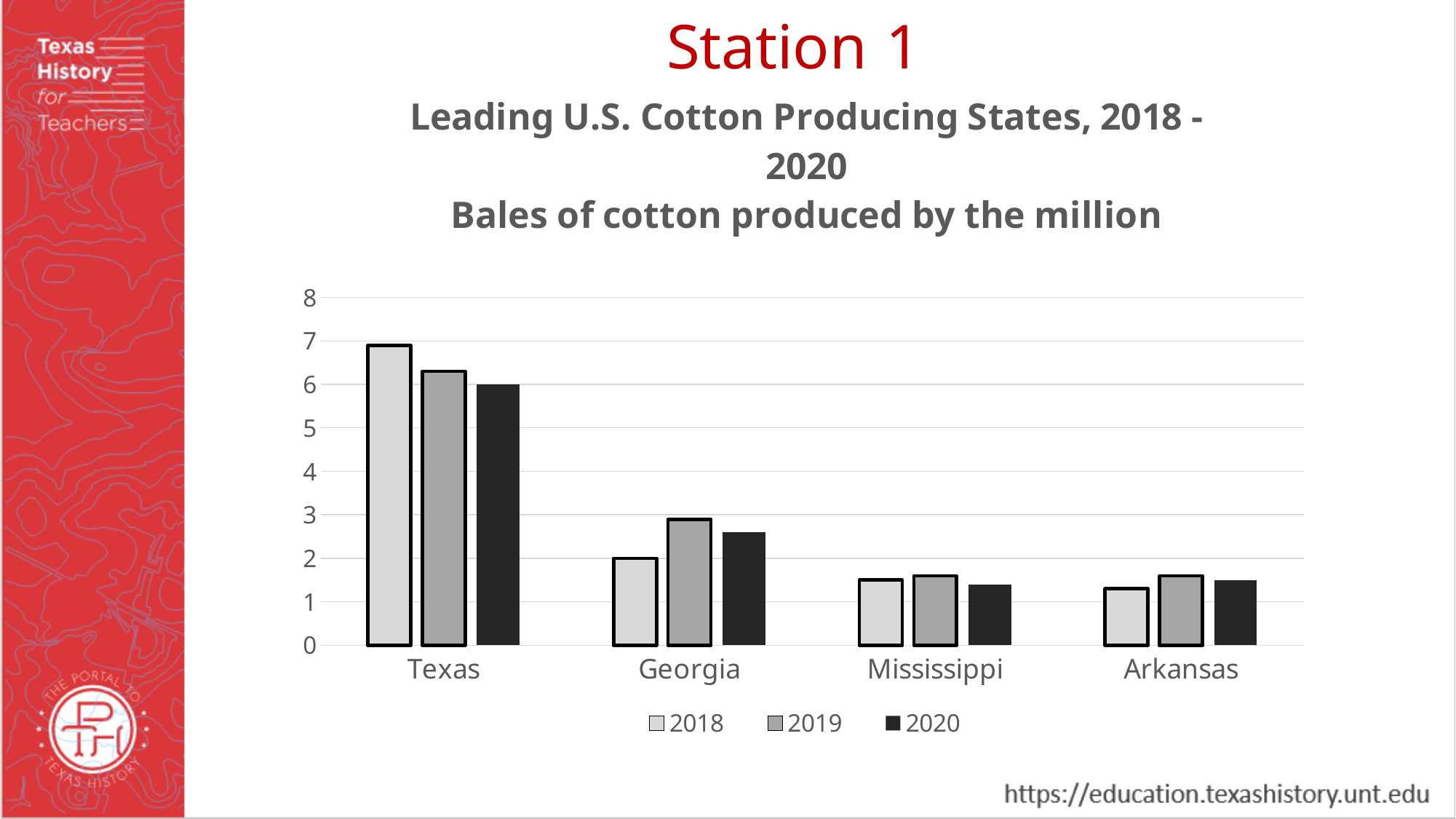
For Georgia, which year has the larger value, 2018 or 2019? 2019 Is the value for Mississippi in 2020 greater or less than 2? less What kind of chart is shown on the slide? Bar chart Which colour represents 2020 in the legend? Black What is the title of the chart? Leading U.S. Cotton Producing States, 2018 - 2020 Bales of cotton produced by the million How many series does the legend list? 3 Which state has the highest cotton production in 2018? Texas Is the value for Texas in 2018 greater or less than 6? greater How many states are shown on the x axis of the chart? 4 Do the values for Texas rise or fall from 2018 to 2020? Fall Which state has the lowest cotton production in 2018? Arkansas